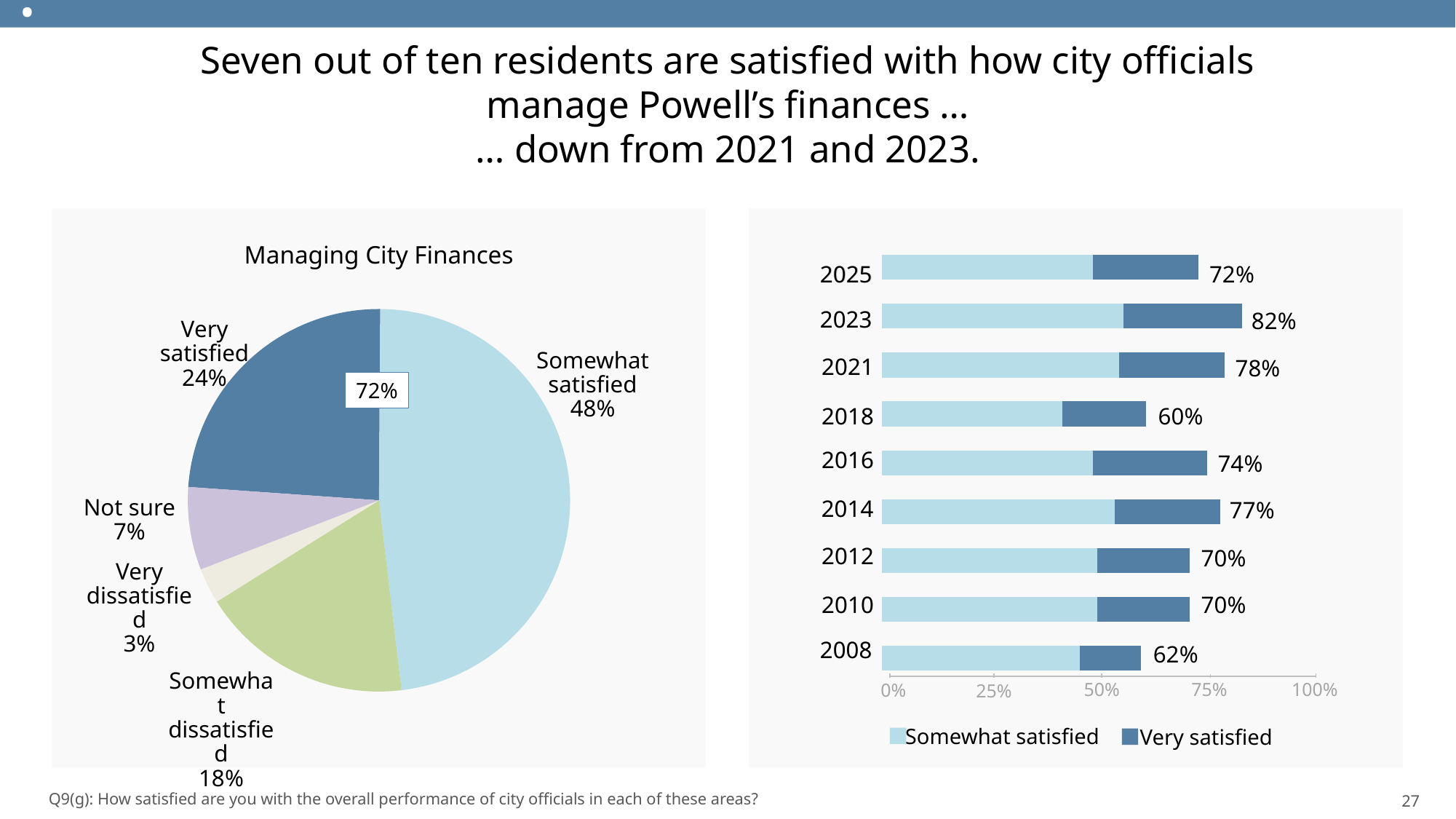
In the pie chart titled Managing City Finances, which category has the largest slice? Somewhat satisfied In the pie chart titled Managing City Finances, how many slices are there? 5 In the pie chart titled Managing City Finances, what percentage of residents are Somewhat satisfied? 48% In the pie chart titled Managing City Finances, what is the difference in percentage points between Very satisfied and Somewhat dissatisfied? 6 percentage points In the bar chart on the right, what is the total satisfied percentage shown for 2023? 82% In the bar chart on the right, how many years are shown? 9 In the pie chart titled Managing City Finances, what percentage is shown for Not sure? 7% In the bar chart on the right, which year has the lowest total satisfied percentage? 2018 In the bar chart on the right, how many series does the legend list? 2 In the pie chart titled Managing City Finances, which category has the smallest slice? Very dissatisfied In the bar chart on the right, which year has the highest total satisfied percentage? 2023 In the bar chart on the right, what is the difference in percentage points between the totals for 2023 and 2025? 10 percentage points